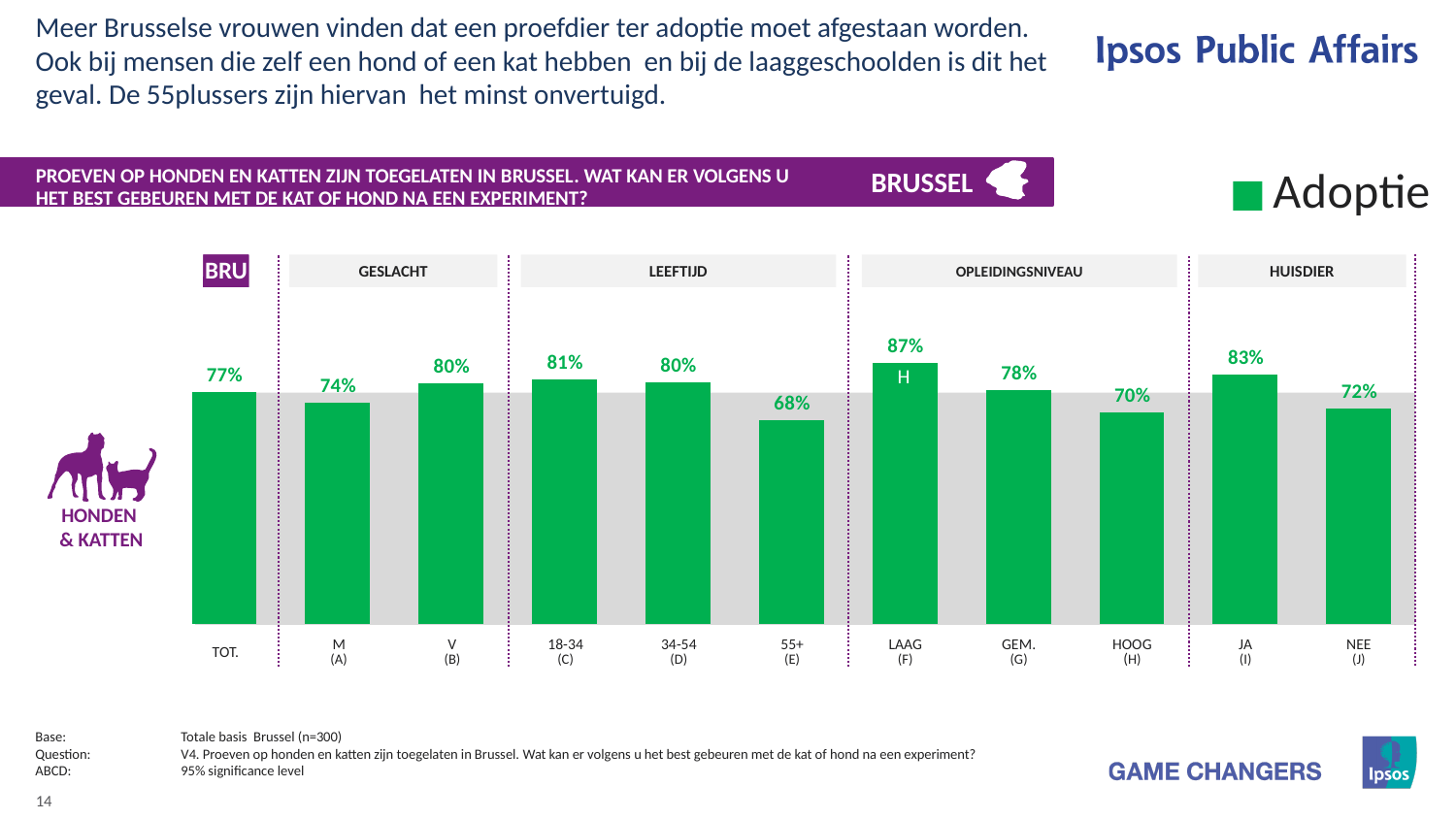
What is the value for LAAG (F) under OPLEIDINGSNIVEAU? 87% What kind of chart is shown on the slide? Bar chart Which category has the highest value in the chart? LAAG (F) What is the difference between the values for V (B) and M (A)? 6% Which category has the lowest value in the chart? 55+ (E) Which is larger, the value for JA (I) or the value for NEE (J)? JA (I) What is the value for the 55+ (E) age group? 68% What is the value for NEE (J) under HUISDIER? 72% How many series does the legend list? 1 How many bars (categories) are plotted in the chart? 11 What is the legend entry shown for the plotted series? Adoptie What is the value for TOT. (total Brussels) in the chart? 77%